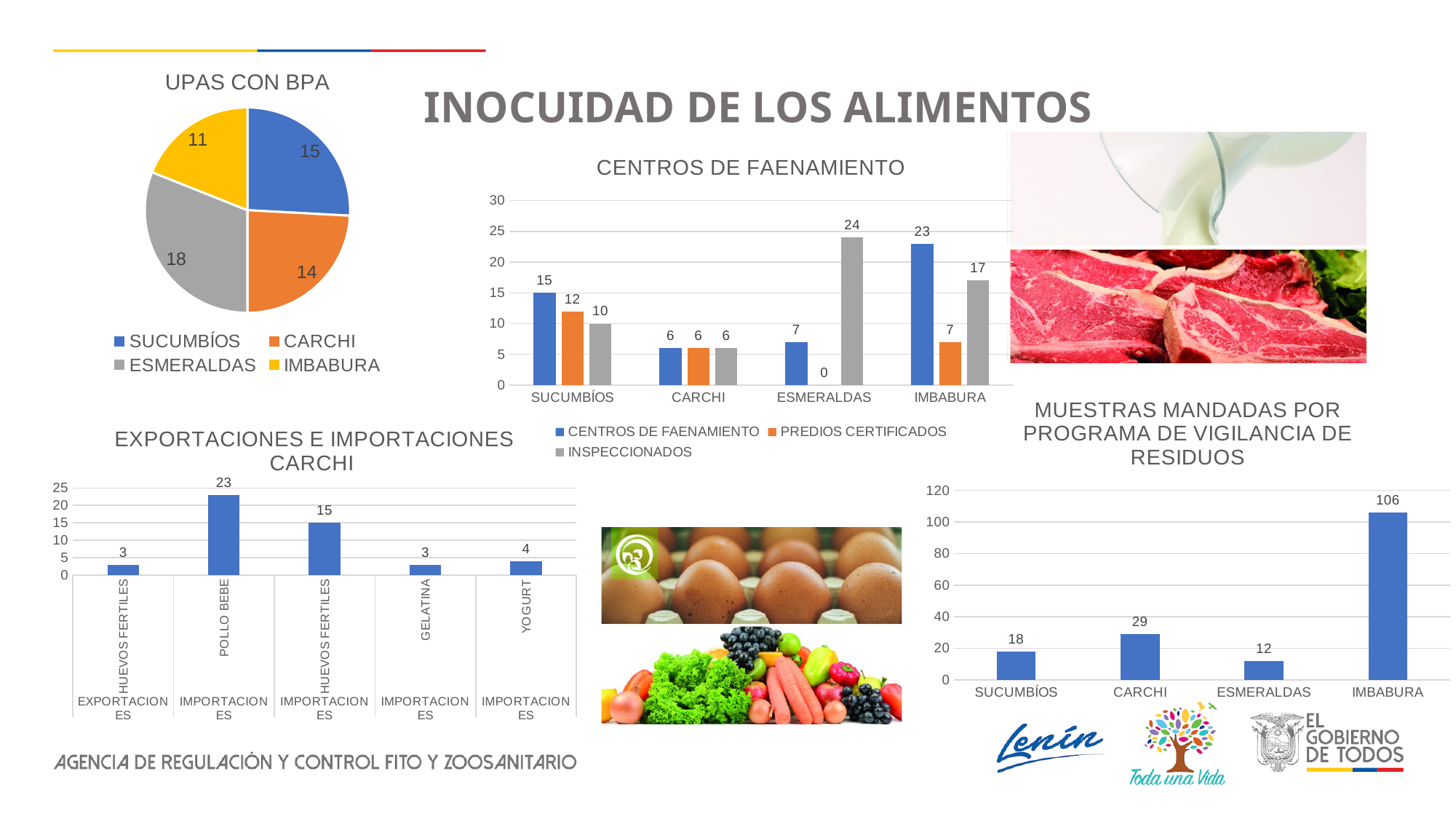
How many series does the legend of the CENTROS DE FAENAMIENTO chart list? 3 In the CENTROS DE FAENAMIENTO chart, what is the INSPECCIONADOS value for ESMERALDAS? 24 In the UPAS CON BPA pie chart, which province has the smallest slice? IMBABURA In the EXPORTACIONES E IMPORTACIONES CARCHI chart, what is the value for POLLO BEBE IMPORTACIONES? 23 In the CENTROS DE FAENAMIENTO chart, what is the PREDIOS CERTIFICADOS value for ESMERALDAS? 0 In the MUESTRAS MANDADAS POR PROGRAMA DE VIGILANCIA DE RESIDUOS chart, which province has the highest value? IMBABURA In the UPAS CON BPA pie chart, what is the value for ESMERALDAS? 18 In the CENTROS DE FAENAMIENTO chart, what is the difference between the CENTROS DE FAENAMIENTO value and the PREDIOS CERTIFICADOS value for IMBABURA? 16 How many bars are plotted in the EXPORTACIONES E IMPORTACIONES CARCHI chart? 5 In the MUESTRAS MANDADAS POR PROGRAMA DE VIGILANCIA DE RESIDUOS chart, is the value for CARCHI larger than the value for SUCUMBÍOS? Yes What kind of chart is UPAS CON BPA? Pie chart In the CENTROS DE FAENAMIENTO chart, which province has the highest CENTROS DE FAENAMIENTO value? IMBABURA